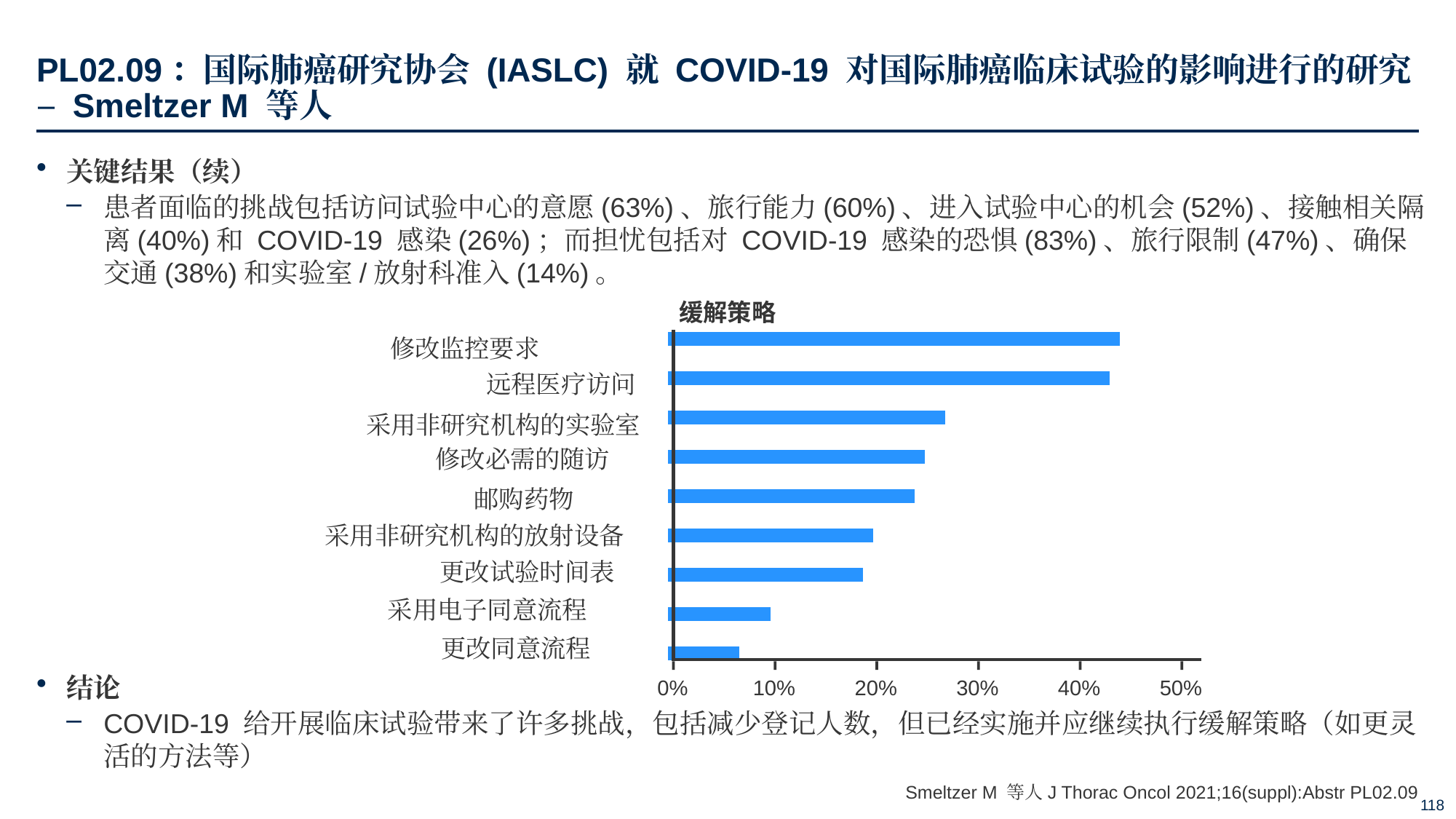
Is the value for 采用非研究机构的实验室 greater or less than 30%? less Which category has the lowest value in the 缓解策略 chart? 更改同意流程 Is the value for 采用电子同意流程 greater or less than 20%? less Which is larger, the value for 采用非研究机构的实验室 or the value for 更改试验时间表? 采用非研究机构的实验室 Is the value for 修改监控要求 greater or less than 40%? greater What is the maximum value shown on the horizontal axis of the 缓解策略 chart? 50% Which is larger, the value for 远程医疗访问 or the value for 邮购药物? 远程医疗访问 How many mitigation strategies (categories) are plotted in the 缓解策略 chart? 9 What kind of chart is shown under the title 缓解策略? bar chart What is the title of the bar chart on the slide? 缓解策略